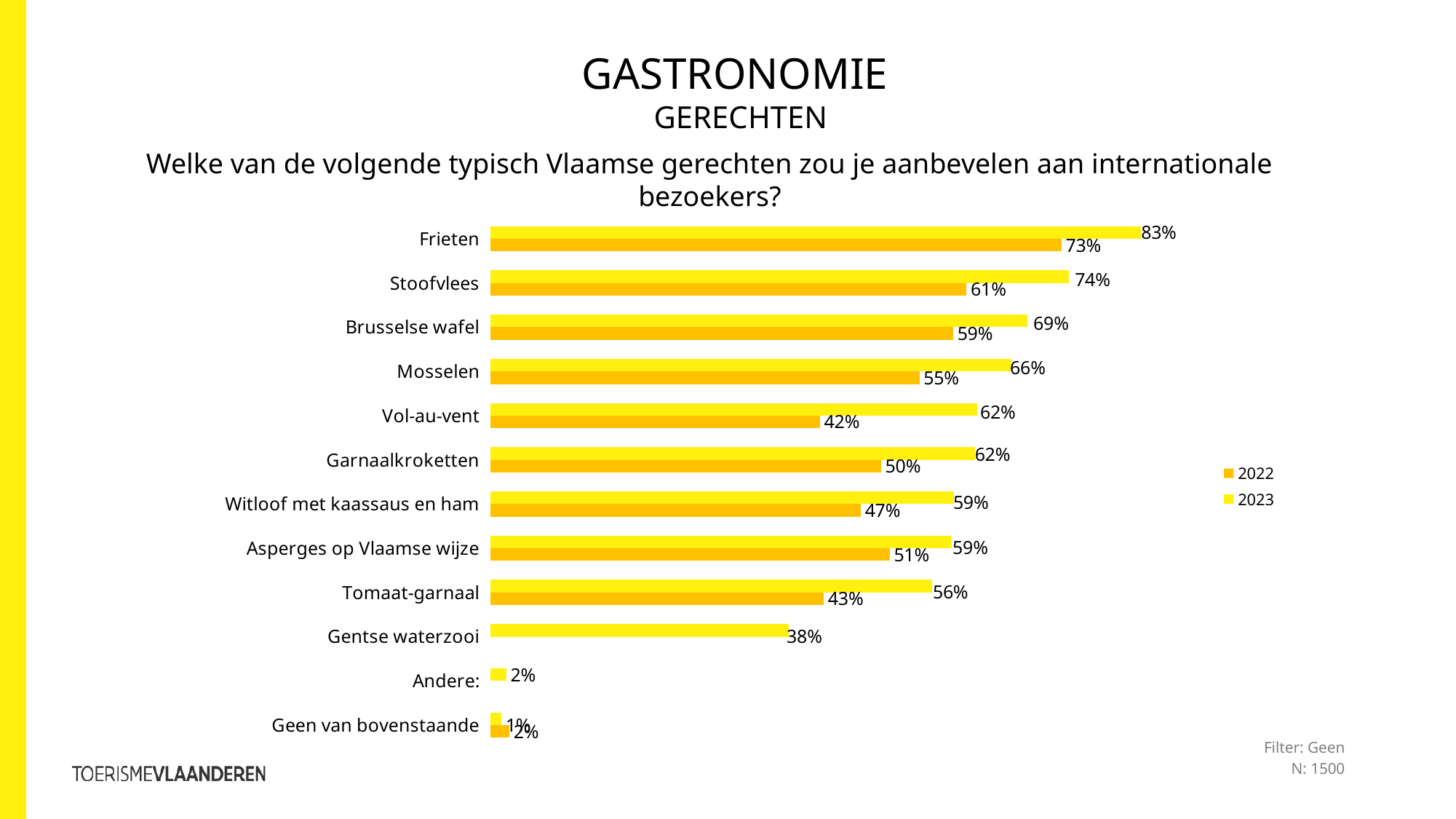
Which years are listed in the legend? 2022 and 2023 Which is larger: the 2022 value for Asperges op Vlaamse wijze or the 2022 value for Garnaalkroketten? Asperges op Vlaamse wijze What kind of chart is shown on the slide? Bar chart What is the difference between the 2023 values for Stoofvlees and Mosselen? 8 percentage points What is the difference between the 2023 and 2022 values for Vol-au-vent? 20 percentage points Which dish has the highest 2023 value? Frieten What is the 2023 value for Gentse waterzooi? 38% Which category has the lowest 2023 value? Geen van bovenstaande How many series does the legend list? 2 What is the 2023 value for Frieten? 83% How many categories are shown on the chart? 12 What is the 2022 value for Vol-au-vent? 42%